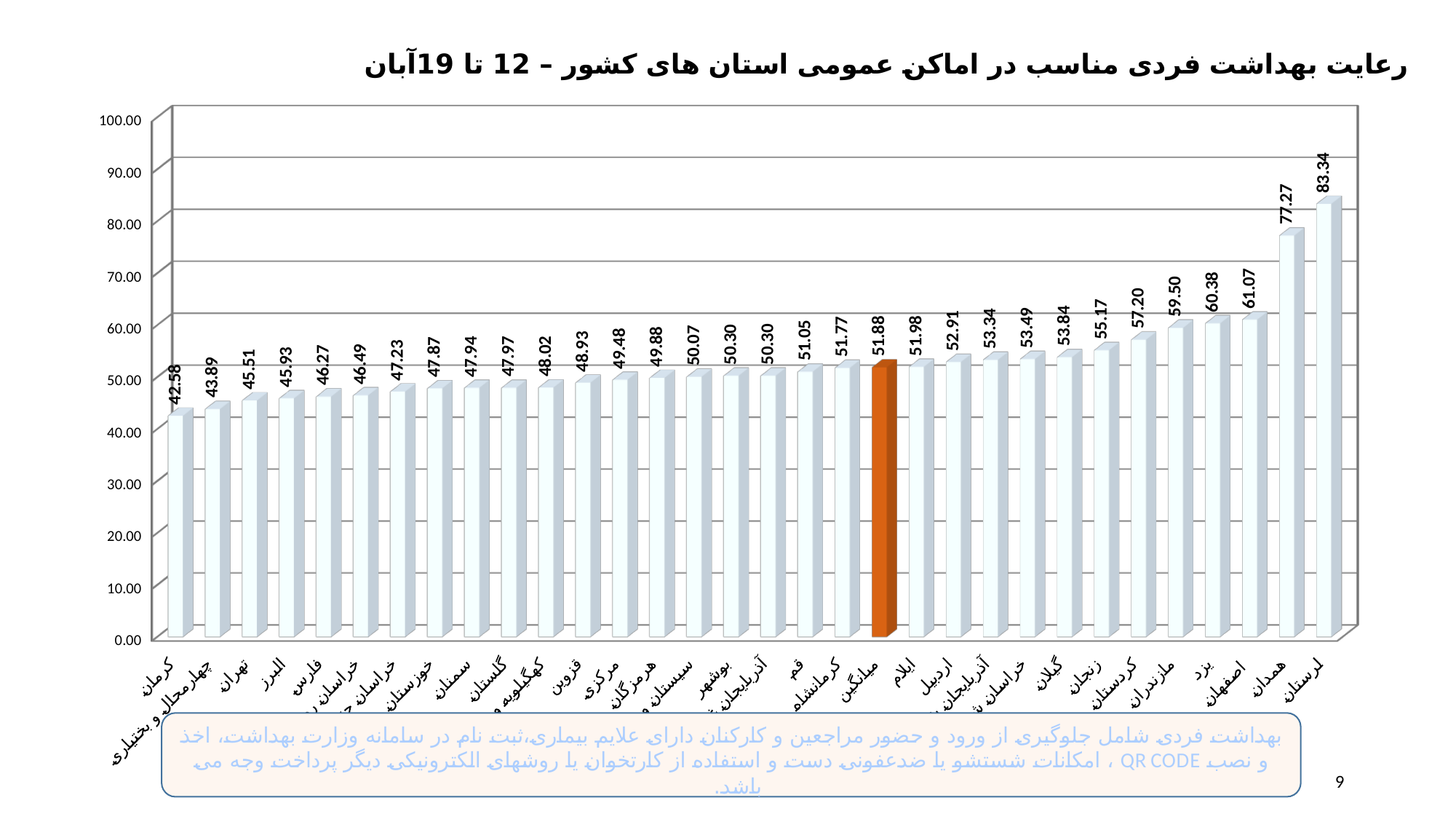
Which province has the highest value? لرستان Do the values rise or fall from left to right along the x axis? rise What is the value shown for میانگین (the orange bar)? 51.88 How many bars are plotted in the chart? 32 Which has a larger value, مازندران or زنجان? مازندران What kind of chart is shown on the slide? bar chart What is the value for اصفهان? 61.07 What is the value for لرستان? 83.34 What is the difference between the values for لرستان and همدان? 6.07 Which province has the lowest value? کرمان What is the value for کرمان? 42.58 Is the value for تهران greater or less than 50.00? less